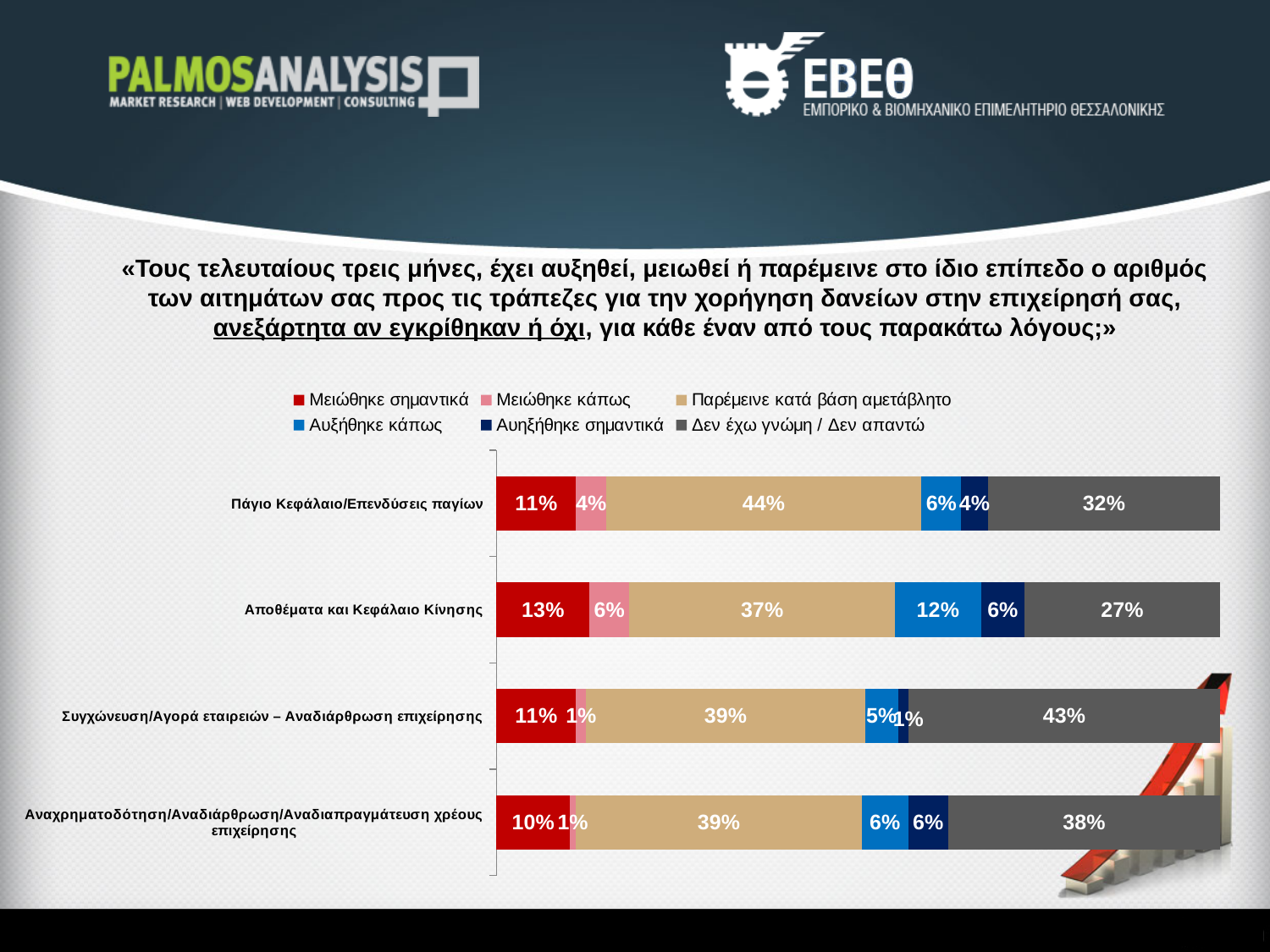
Which category has the highest value for "Μειώθηκε σημαντικά"? Αποθέματα και Κεφάλαιο Κίνησης What is the value of "Μειώθηκε σημαντικά" for "Αναχρηματοδότηση/Αναδιάρθρωση/Αναδιαπραγμάτευση χρέους επιχείρησης"? 10% How many series does the legend list? 6 What kind of chart is shown on the slide? Stacked bar chart How many categories are plotted on the chart? 4 What colour represents "Δεν έχω γνώμη / Δεν απαντώ" in the chart? Grey What is the value of "Αυξήθηκε κάπως" for "Αποθέματα και Κεφάλαιο Κίνησης"? 12% What is the difference between the "Παρέμεινε κατά βάση αμετάβλητο" values for "Πάγιο Κεφάλαιο/Επενδύσεις παγίων" and "Αποθέματα και Κεφάλαιο Κίνησης"? 7% What is the value of "Δεν έχω γνώμη / Δεν απαντώ" for "Συγχώνευση/Αγορά εταιρειών – Αναδιάρθρωση επιχείρησης"? 43% Which category has the lowest value for "Δεν έχω γνώμη / Δεν απαντώ"? Αποθέματα και Κεφάλαιο Κίνησης What is the value of "Παρέμεινε κατά βάση αμετάβλητο" for "Πάγιο Κεφάλαιο/Επενδύσεις παγίων"? 44% Which is larger: the "Αυξήθηκε σημαντικά" value for "Αποθέματα και Κεφάλαιο Κίνησης" or for "Πάγιο Κεφάλαιο/Επενδύσεις παγίων"? Αποθέματα και Κεφάλαιο Κίνησης